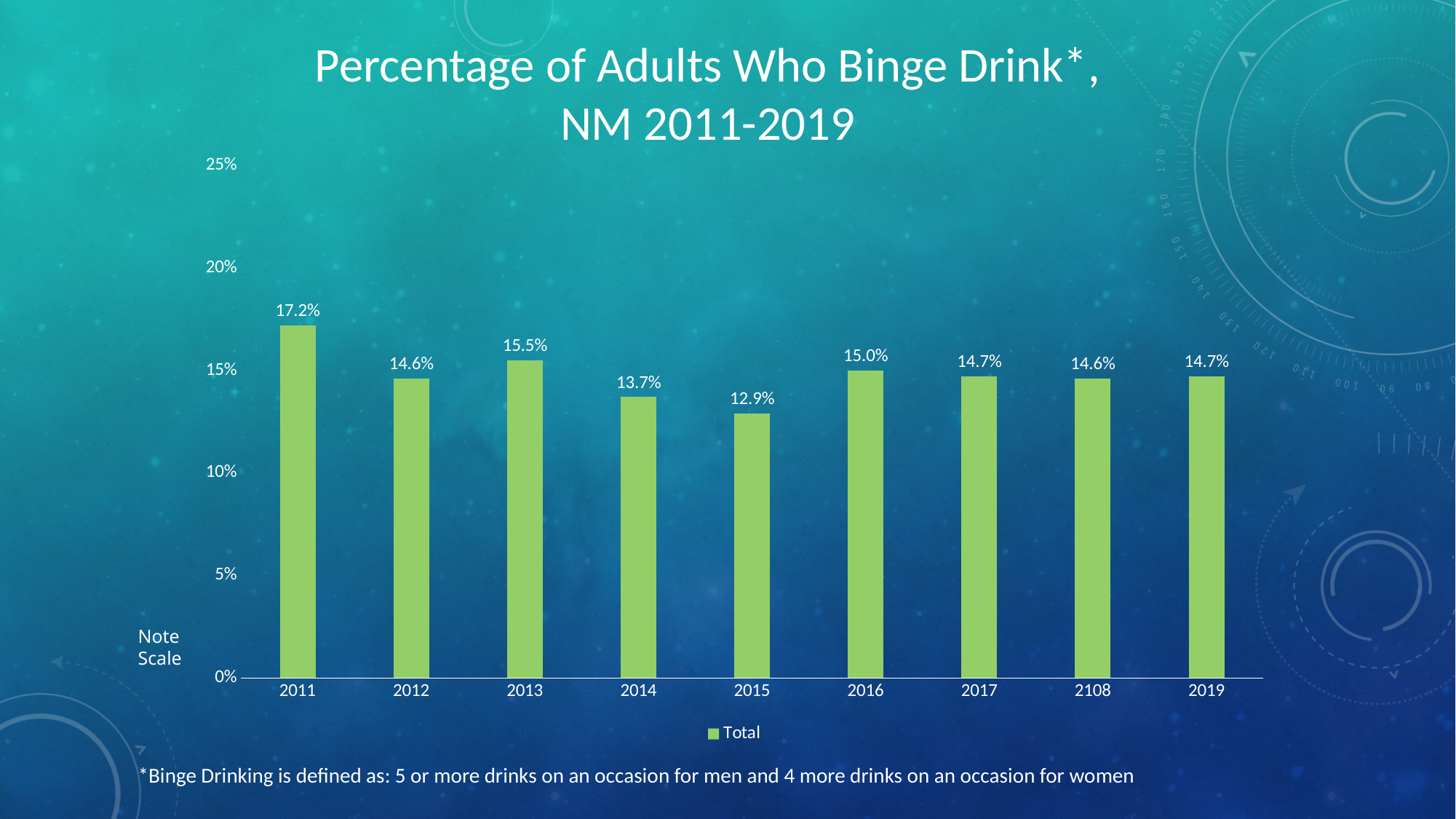
Which year has the lowest percentage of adults who binge drink? 2015 What is the difference between the 2011 value and the 2015 value? 4.3% What is the value shown for 2019? 14.7% Is the value for 2014 greater or less than 15%? less How many years are shown on the x axis? 9 Which is larger, the value for 2013 or the value for 2016? 2013 Which year has the highest percentage of adults who binge drink? 2011 What is the value shown for 2015? 12.9% What kind of chart is shown on the slide? bar chart What percentage of adults binge drank in 2011? 17.2% What is the difference between the 2013 value and the 2014 value? 1.8% What is the value shown for 2016? 15.0%